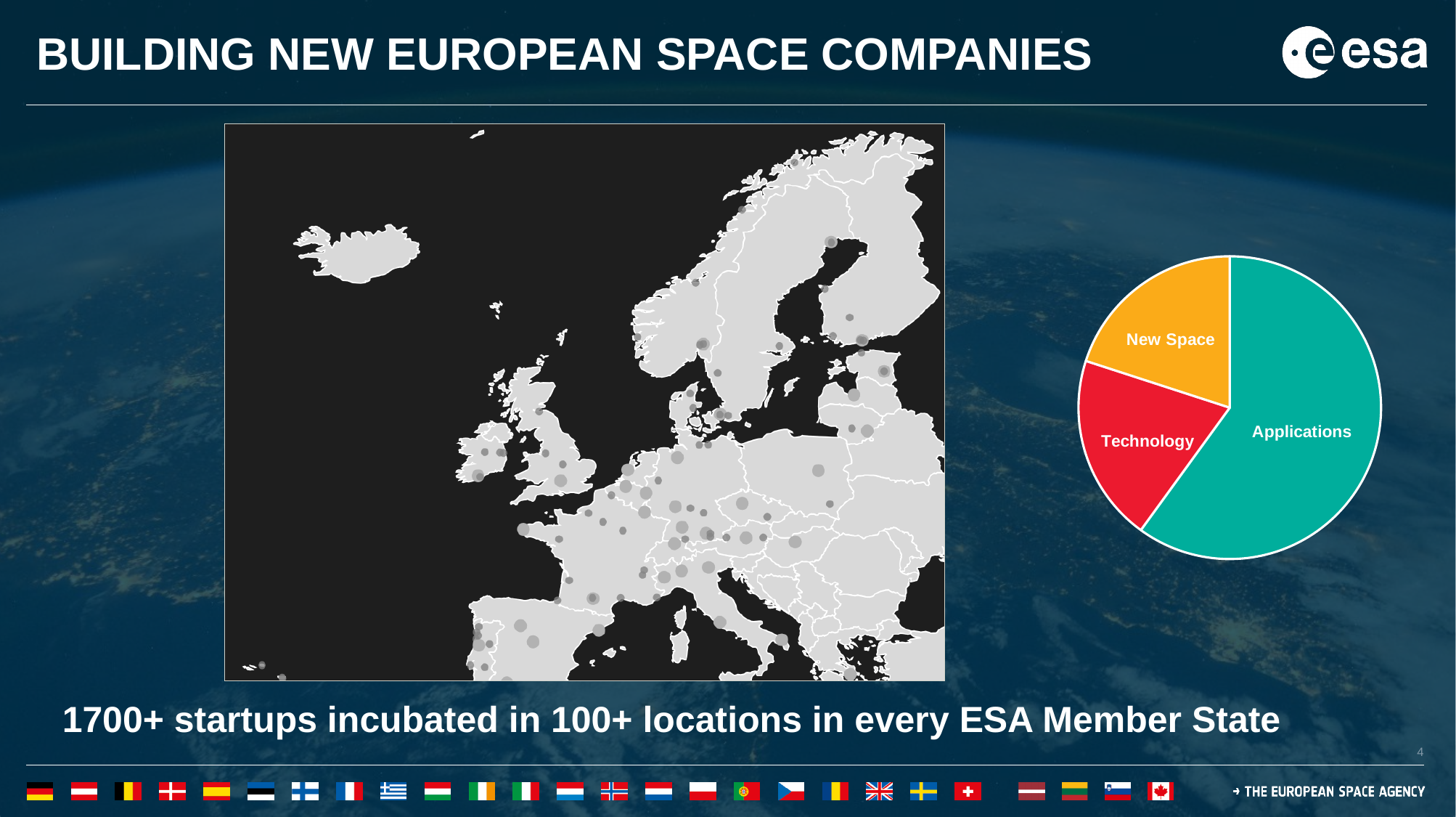
How many slices does the pie chart have? 3 In the pie chart, which slice is larger: Applications or Technology? Applications In the pie chart, which slice is larger: Applications or New Space? Applications Which category in the pie chart is shown in red? Technology Which category has the largest slice in the pie chart? Applications What colour is the Applications slice in the pie chart? Teal What kind of chart is shown on the right side of the slide? Pie chart